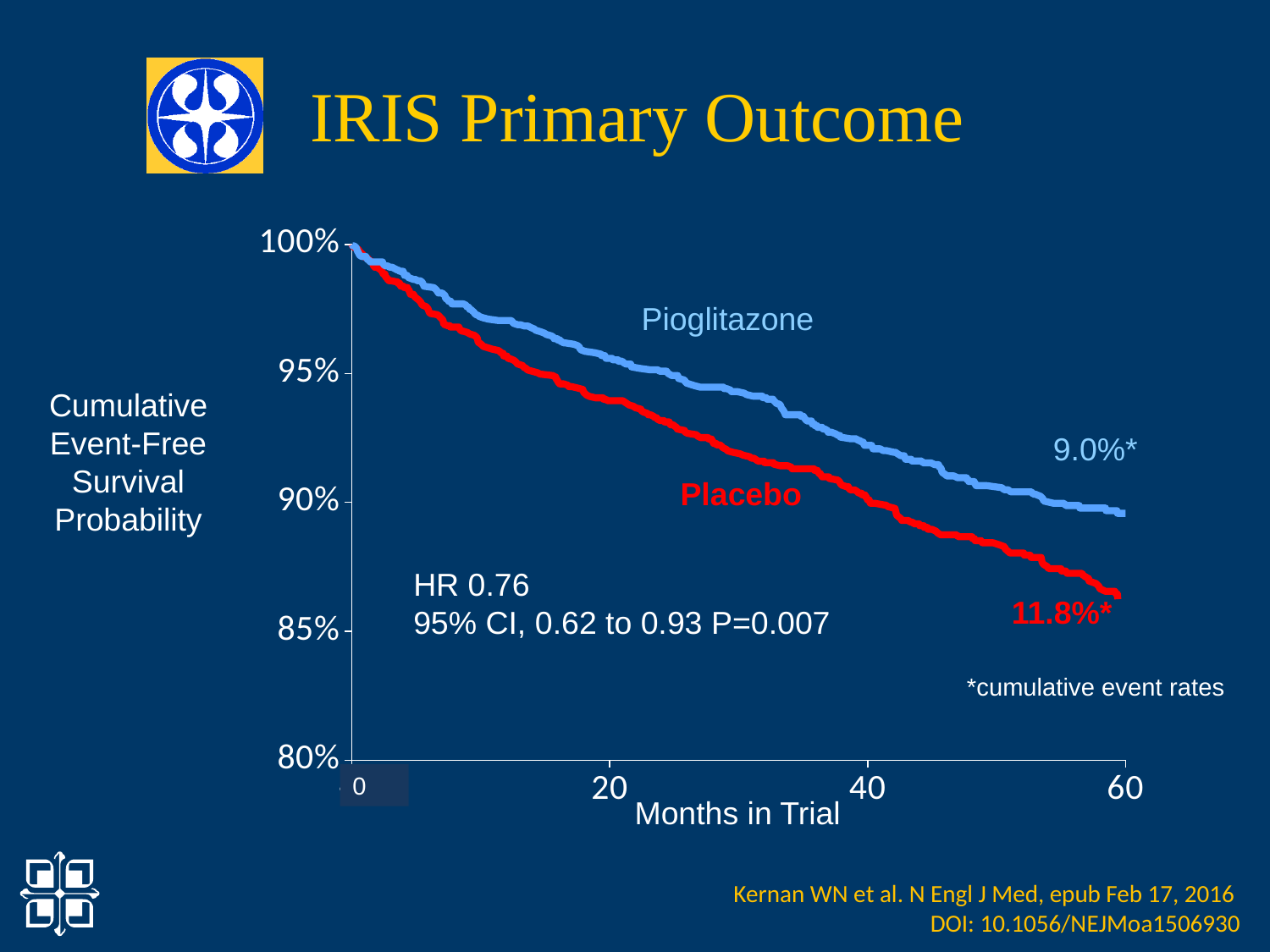
What kind of chart is shown on the slide? line chart Do the survival curves rise or fall as months in trial increase? fall What hazard ratio is reported on the chart? HR 0.76 What is the difference between the Placebo and Pioglitazone cumulative event rates? 2.8 percentage points At 40 months in trial, which curve shows the higher event-free survival probability? Pioglitazone Which group has the higher cumulative event rate, Pioglitazone or Placebo? Placebo What is the cumulative event rate shown for the Placebo group? 11.8% Is the Placebo event-free survival probability at 60 months greater or less than 90%? less Is the Pioglitazone event-free survival probability at 40 months greater or less than 90%? greater What is the cumulative event rate shown for the Pioglitazone group? 9.0% How many series (treatment groups) are plotted on the chart? 2 What is the label of the x axis? Months in Trial